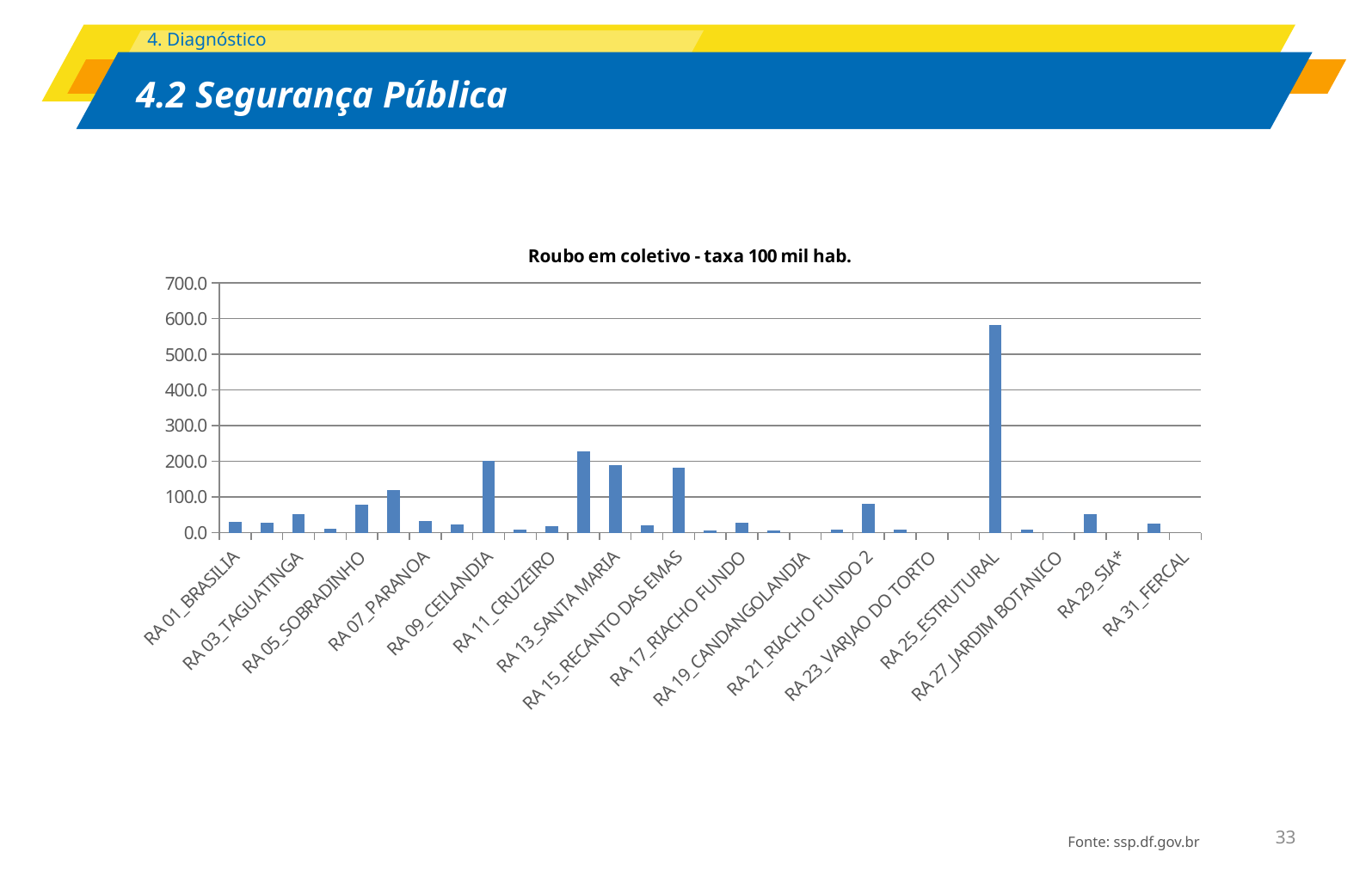
Which category has the highest value in the chart? RA 25_ESTRUTURAL Which is larger, the value for RA 25_ESTRUTURAL or the value for RA 13_SANTA MARIA? RA 25_ESTRUTURAL Is the value for RA 05_SOBRADINHO greater or less than 100.0? less What kind of chart is shown on the slide? bar chart Which is larger, the value for RA 09_CEILANDIA or the value for RA 05_SOBRADINHO? RA 09_CEILANDIA Is the value for RA 07_PARANOA greater or less than 100.0? less What source is cited for the chart at the bottom of the slide? ssp.df.gov.br Is the value for RA 25_ESTRUTURAL greater or less than 500.0? greater How many category labels are shown on the x axis of the chart? 16 What is the title of the chart? Roubo em coletivo - taxa 100 mil hab.